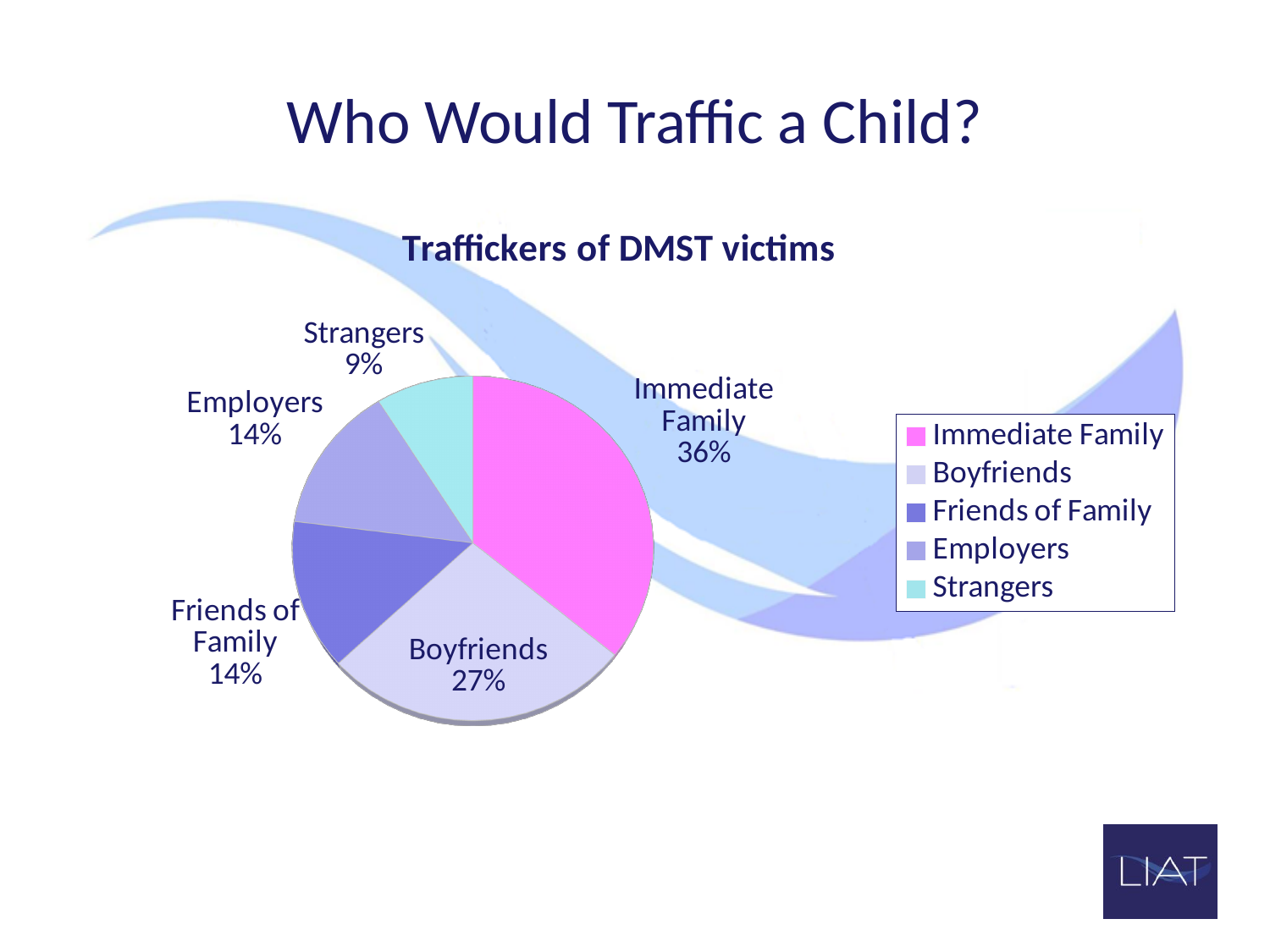
Which category has the largest share of the pie? Immediate Family What is the difference in percentage points between Immediate Family and Boyfriends? 9 What share of the pie is Employers? 14% Which is larger, the share for Boyfriends or the share for Employers? Boyfriends How many entries does the legend list? 5 Which category has the smallest share of the pie? Strangers What share of the pie is Immediate Family? 36% What share of the pie is Boyfriends? 27% How many categories does the pie chart show? 5 What is the title of the chart? Traffickers of DMST victims What type of chart is shown on the slide? Pie chart